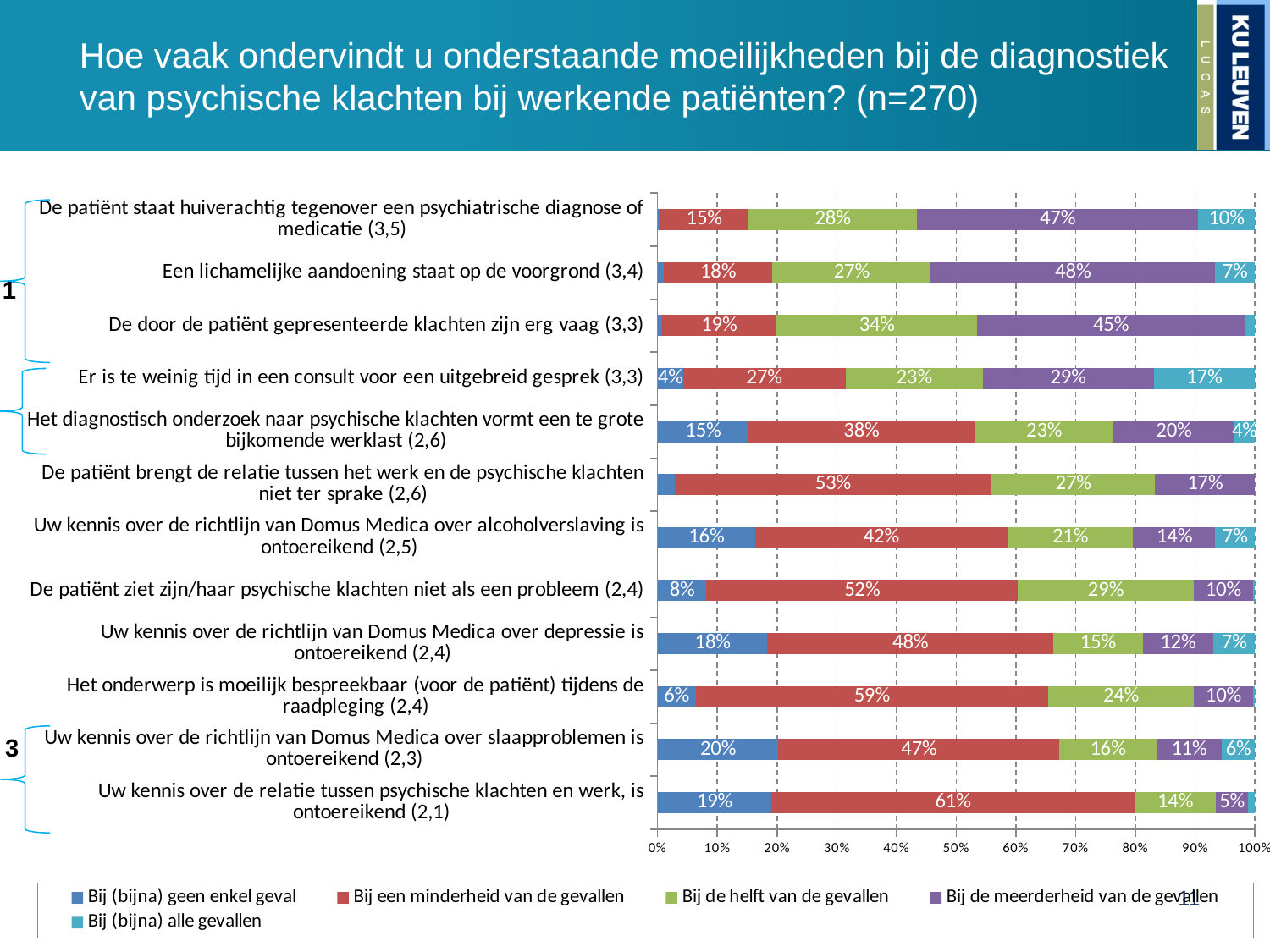
Which category has the highest value for 'Bij de meerderheid van de gevallen'? Een lichamelijke aandoening staat op de voorgrond (3,4) What is the value of 'Bij een minderheid van de gevallen' for 'Uw kennis over de relatie tussen psychische klachten en werk, is ontoereikend (2,1)'? 61% What kind of chart is shown on the slide? Stacked bar chart What is the value of 'Bij (bijna) alle gevallen' for 'Er is te weinig tijd in een consult voor een uitgebreid gesprek (3,3)'? 17% Which category has the highest value for 'Bij een minderheid van de gevallen'? Uw kennis over de relatie tussen psychische klachten en werk, is ontoereikend (2,1) What is the difference between the 'Bij de helft van de gevallen' values for 'De door de patiënt gepresenteerde klachten zijn erg vaag (3,3)' and 'Uw kennis over de richtlijn van Domus Medica over depressie is ontoereikend (2,4)'? 19% Which is larger: the 'Bij een minderheid van de gevallen' value for 'Het onderwerp is moeilijk bespreekbaar (voor de patiënt) tijdens de raadpleging (2,4)' or for 'De patiënt ziet zijn/haar psychische klachten niet als een probleem (2,4)'? Het onderwerp is moeilijk bespreekbaar (voor de patiënt) tijdens de raadpleging (2,4) How many categories (statements) are plotted in the chart? 12 How many series does the legend list? 5 What is the value of 'Bij de meerderheid van de gevallen' for 'Een lichamelijke aandoening staat op de voorgrond (3,4)'? 48% Which colour represents 'Bij de helft van de gevallen' in the legend? Green What is the value of 'Bij (bijna) geen enkel geval' for 'Uw kennis over de richtlijn van Domus Medica over slaapproblemen is ontoereikend (2,3)'? 20%